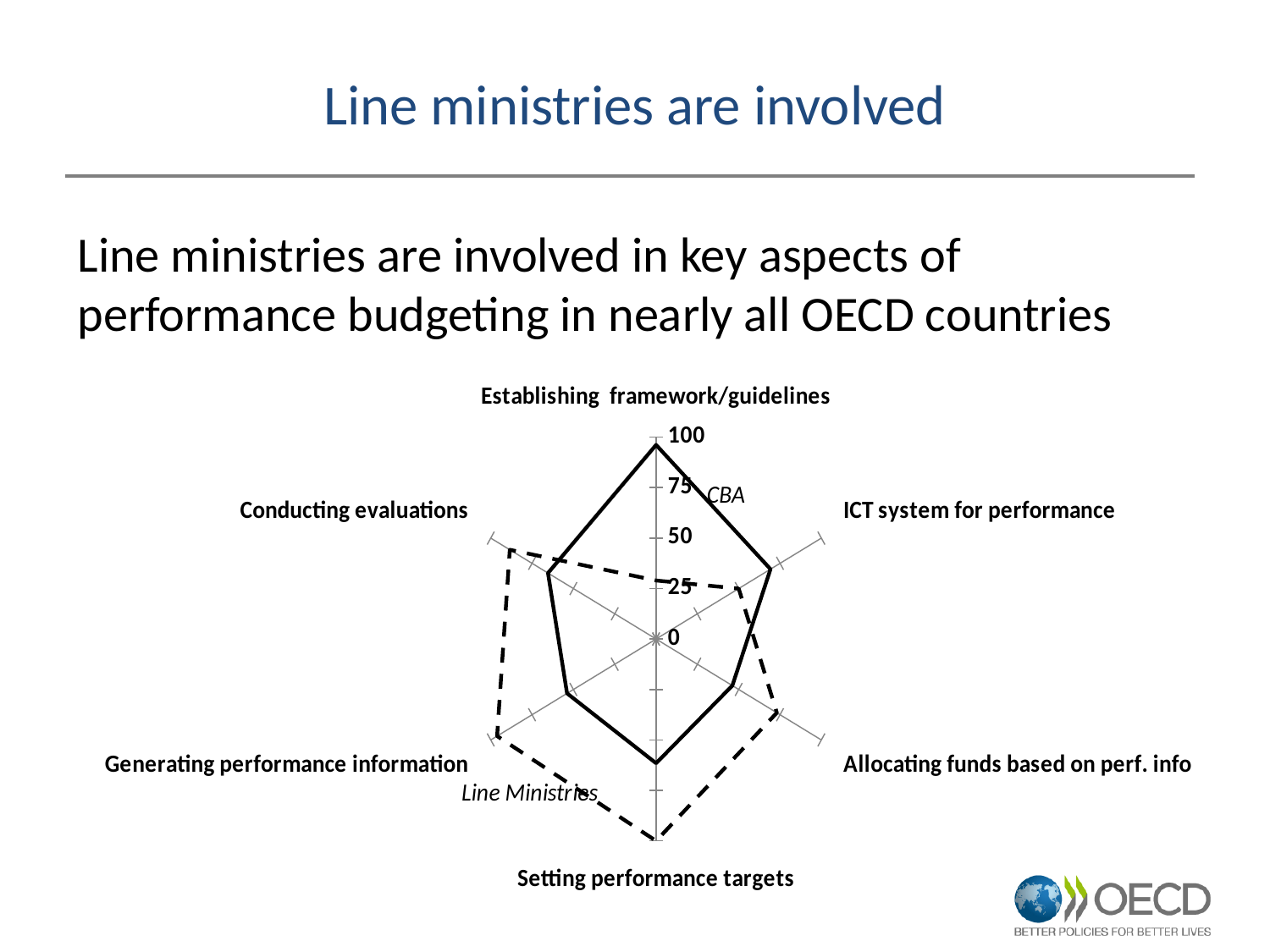
Which series is drawn with a dashed line? Line Ministries Is the CBA value for Setting performance targets greater or less than 75? less What kind of chart is shown on the slide? Radar chart Is the Line Ministries value for Establishing framework/guidelines greater or less than 50? less For which category does the Line Ministries series have its lowest value? Establishing framework/guidelines Is the Line Ministries value for Setting performance targets greater or less than 75? greater How many series does the chart plot? 2 For Setting performance targets, which series has the larger value, CBA or Line Ministries? Line Ministries For which category does the CBA series reach its highest value? Establishing framework/guidelines How many categories (axes) does the radar chart have? 6 For Establishing framework/guidelines, which series has the larger value, CBA or Line Ministries? CBA